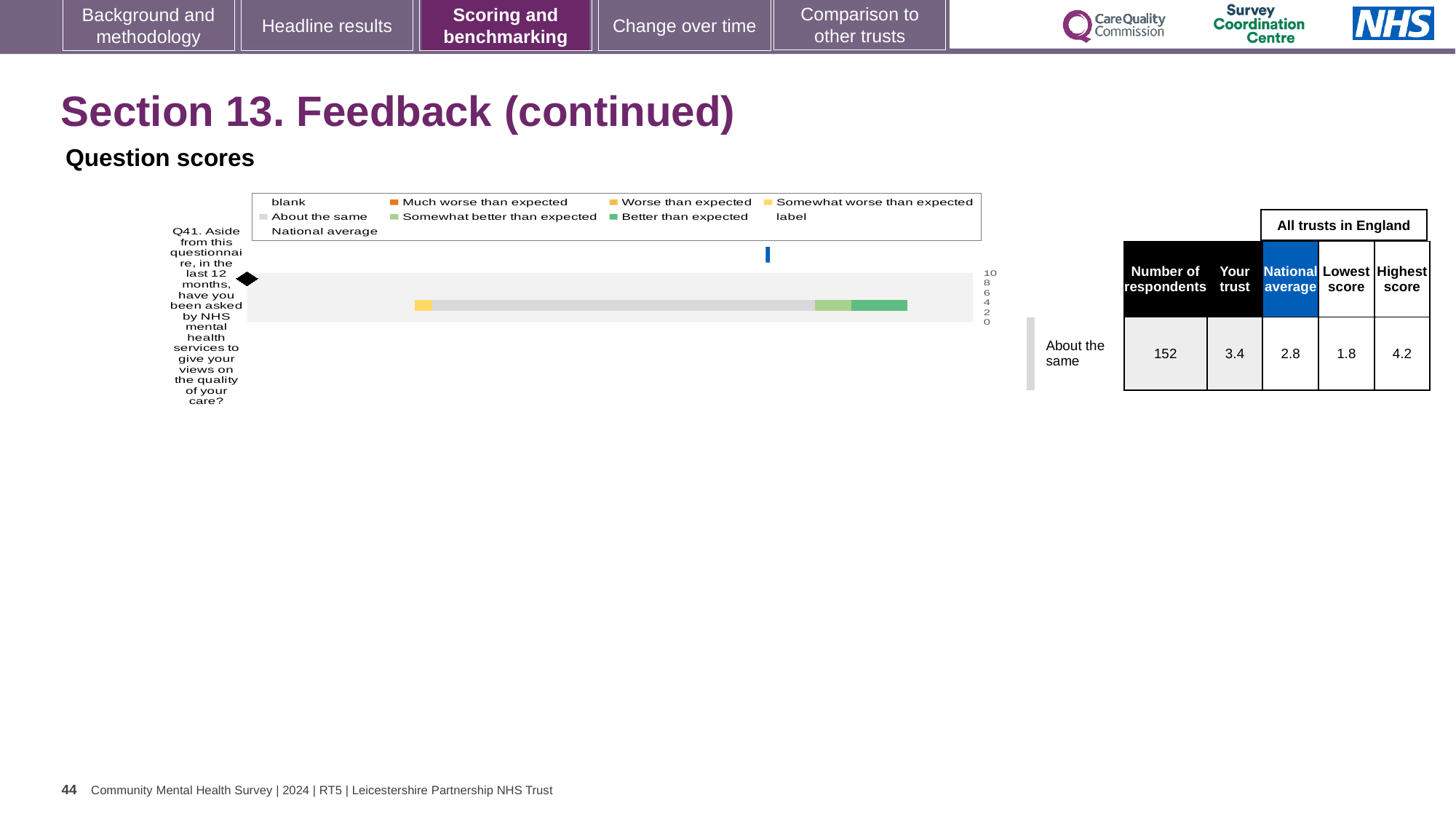
Which benchmark category is the trust's Q41 score placed in? About the same Is the 'Your trust' score for Q41 greater or less than 2? greater What is the 'Your trust' score for Q41? 3.4 By how much does the 'Your trust' score for Q41 exceed the national average? 0.6 How many survey questions are plotted in the chart? 1 What is the lowest score among all trusts in England for Q41? 1.8 What is the highest score among all trusts in England for Q41? 4.2 What is the difference between the highest and lowest trust scores for Q41? 2.4 What is the national average score for Q41? 2.8 How many respondents answered Q41? 152 Which is larger for Q41: the 'Your trust' score or the national average? Your trust What kind of chart is used to show the Q41 question score? Bar chart